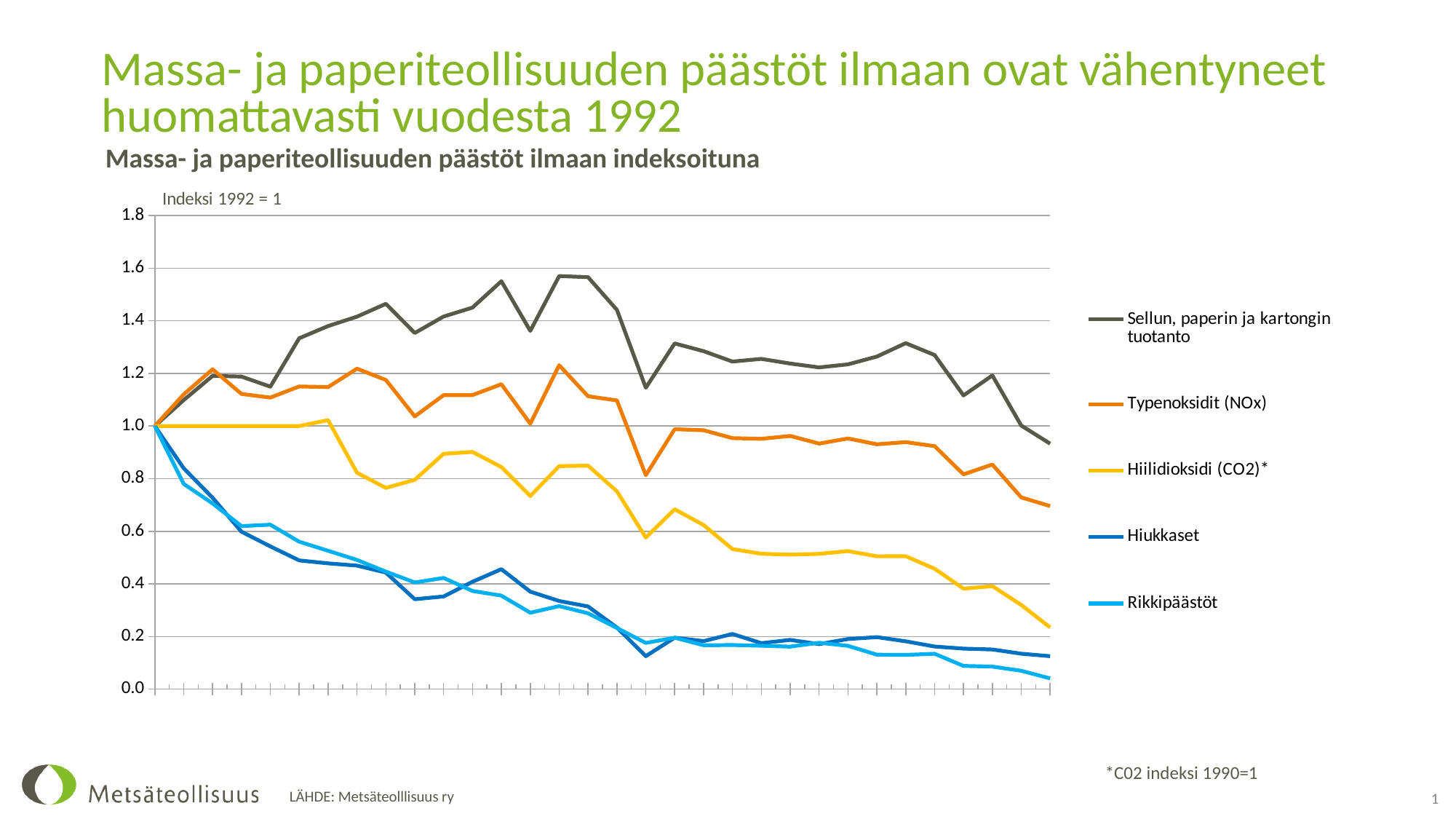
What kind of chart is shown on the slide? line chart Which series has the lowest value at the right end of the chart? Rikkipäästöt Do the values of the Rikkipäästöt series rise or fall along the x axis? fall Which series is drawn in orange? Typenoksidit (NOx) Which series has the highest value at the right end of the chart? Sellun, paperin ja kartongin tuotanto At the right end of the chart, which is higher: Typenoksidit (NOx) or Hiilidioksidi (CO2)*? Typenoksidit (NOx) What is the value of the Rikkipäästöt series at the first point on the x axis? 1.0 Is the value of Rikkipäästöt at the right end of the chart greater or less than 0.2? less Is the peak value of Sellun, paperin ja kartongin tuotanto greater or less than 1.4? greater How many series does the legend list? 5 Is the value of Typenoksidit (NOx) at the right end of the chart greater or less than 0.8? less What is the title of the chart? Massa- ja paperiteollisuuden päästöt ilmaan indeksoituna